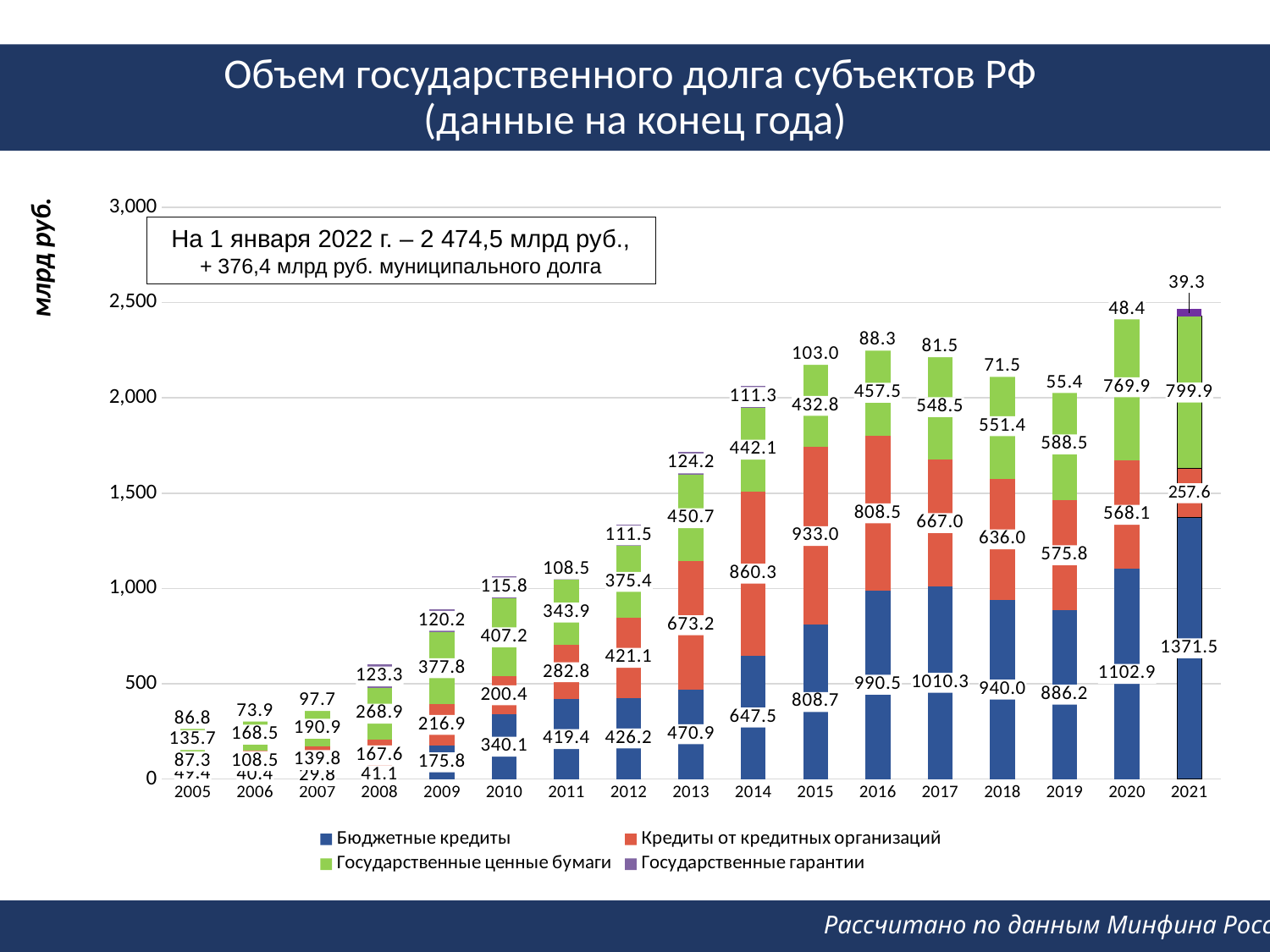
What kind of chart is shown on the slide? Stacked bar chart In which year is Кредиты от кредитных организаций highest? 2015 What is the difference between Бюджетные кредиты in 2021 and in 2020? 268.6 What is the value of Кредиты от кредитных организаций for 2015? 933.0 What is the value of Бюджетные кредиты for 2021? 1371.5 What is the value of Государственные гарантии for 2016? 88.3 Which is larger: Кредиты от кредитных организаций in 2015 or in 2016? 2015 How many years are shown on the x axis? 17 What is the value of Государственные ценные бумаги for 2021? 799.9 How many series does the legend list? 4 In which year is Бюджетные кредиты highest? 2021 Is the total height of the stacked bar for 2014 greater or less than 1,500? greater